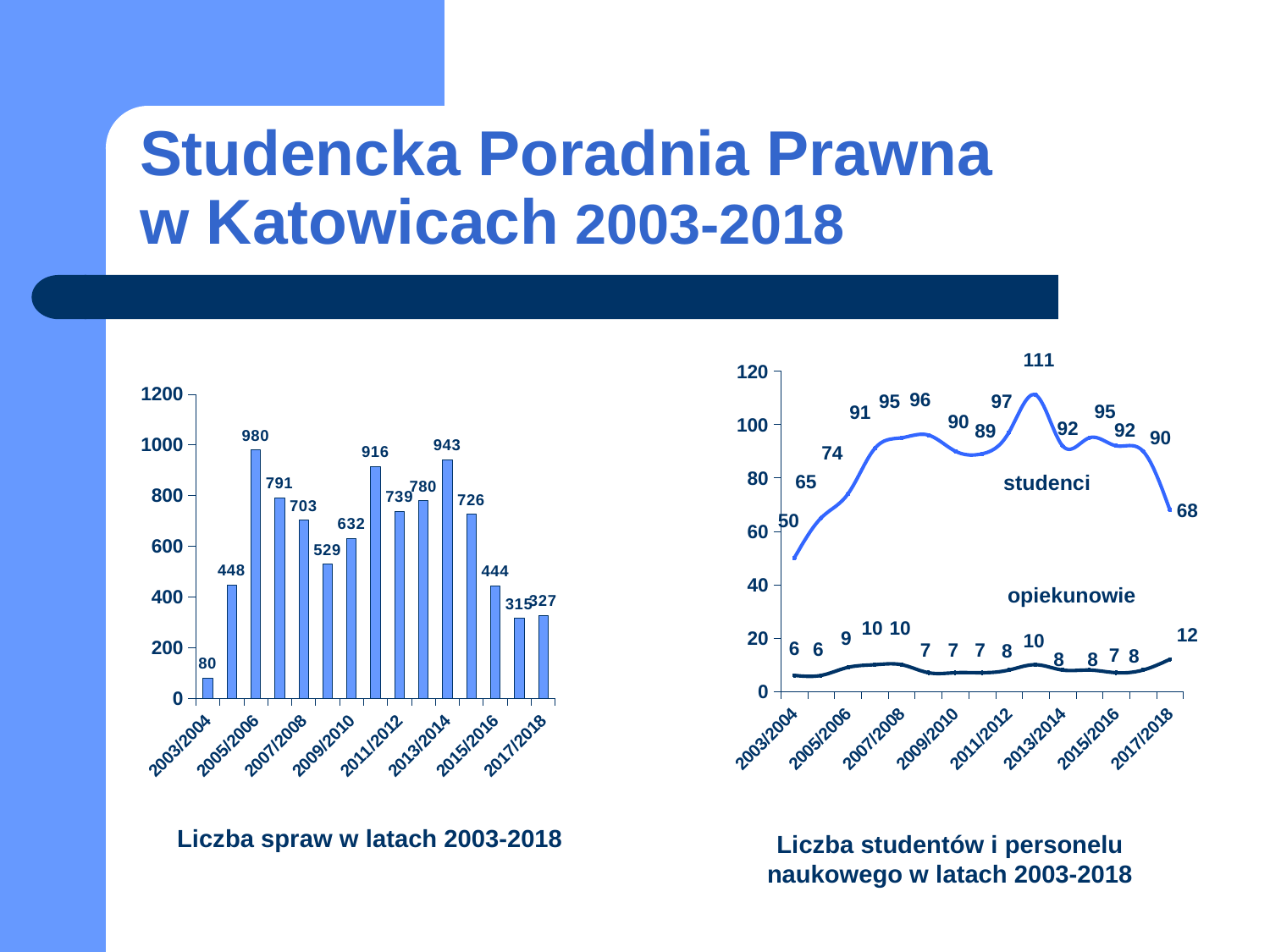
In the chart 'Liczba spraw w latach 2003-2018', what is the difference between the values for 2005/2006 and 2003/2004? 900 In the chart 'Liczba studentów i personelu naukowego w latach 2003-2018', what is the value for opiekunowie in 2017/2018? 12 In the chart 'Liczba studentów i personelu naukowego w latach 2003-2018', what is the highest value reached by the studenci series? 111 In the chart 'Liczba spraw w latach 2003-2018', how many bars are plotted? 15 How many series are plotted in the chart 'Liczba studentów i personelu naukowego w latach 2003-2018'? 2 In the chart 'Liczba spraw w latach 2003-2018', which year has the highest number of cases? 2005/2006 In the chart 'Liczba spraw w latach 2003-2018', what is the value for 2017/2018? 327 What kind of chart is 'Liczba spraw w latach 2003-2018'? bar chart In the chart 'Liczba studentów i personelu naukowego w latach 2003-2018', what is the difference between studenci and opiekunowie in 2017/2018? 56 In the chart 'Liczba studentów i personelu naukowego w latach 2003-2018', what is the value for studenci in 2003/2004? 50 In the chart 'Liczba spraw w latach 2003-2018', what is the value for 2003/2004? 80 In the chart 'Liczba spraw w latach 2003-2018', which year has the lowest number of cases? 2003/2004